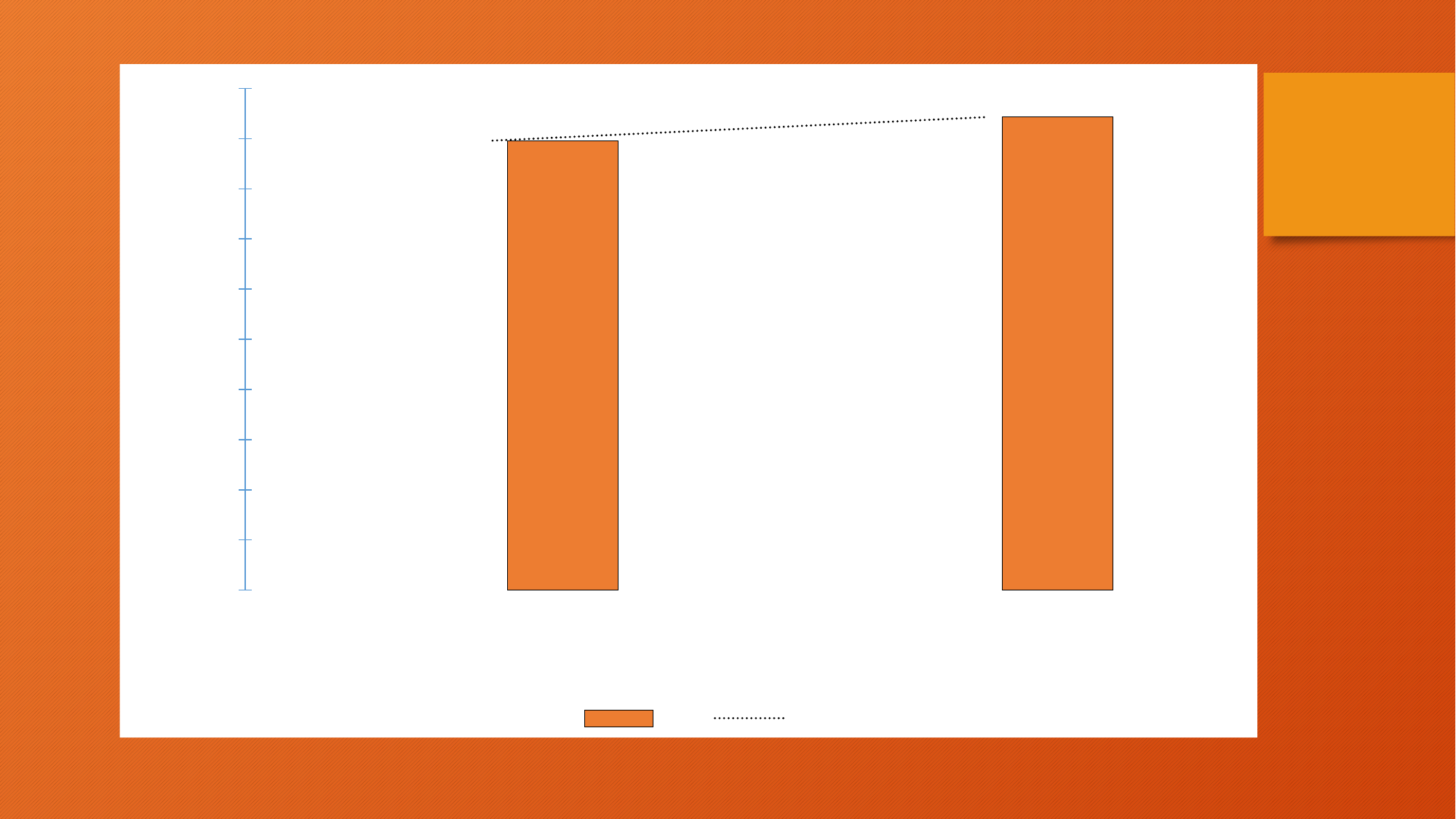
Which bar has the lowest value? the left bar Which bar is taller, the left bar or the right bar? the right bar What kind of chart is shown on the slide? bar chart How many entries does the chart's legend list? 2 What style of line is drawn across the tops of the bars? a dotted line How many bars are plotted in the chart? 2 Which bar has the highest value? the right bar What colour are the bars in the chart? orange Do the bar values rise or fall from left to right? rise